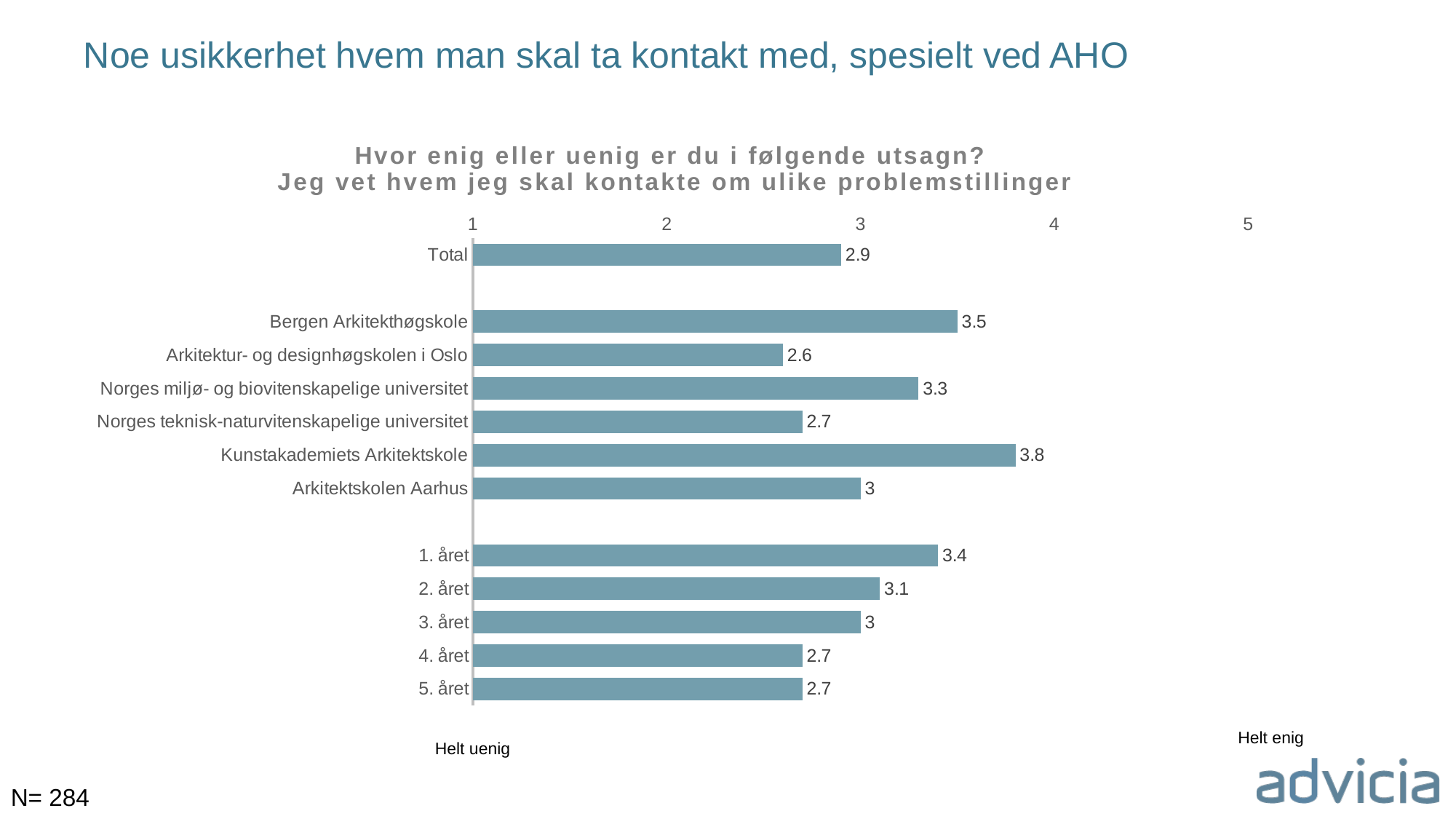
What is the value for 1. året? 3.4 How many bars are plotted in the chart? 12 Which is larger, the value for Norges miljø- og biovitenskapelige universitet or the value for Norges teknisk-naturvitenskapelige universitet? Norges miljø- og biovitenskapelige universitet What is the value for Kunstakademiets Arkitektskole? 3.8 Is the value for 2. året greater or less than 3? greater Which category has the highest value? Kunstakademiets Arkitektskole What is the value for Arkitektur- og designhøgskolen i Oslo? 2.6 What is the difference between the values for Bergen Arkitekthøgskole and Arkitektur- og designhøgskolen i Oslo? 0.9 What is the value for Total? 2.9 Which category has the lowest value? Arkitektur- og designhøgskolen i Oslo What kind of chart is shown on the slide? bar chart What is the sample size (N) shown on the slide? 284